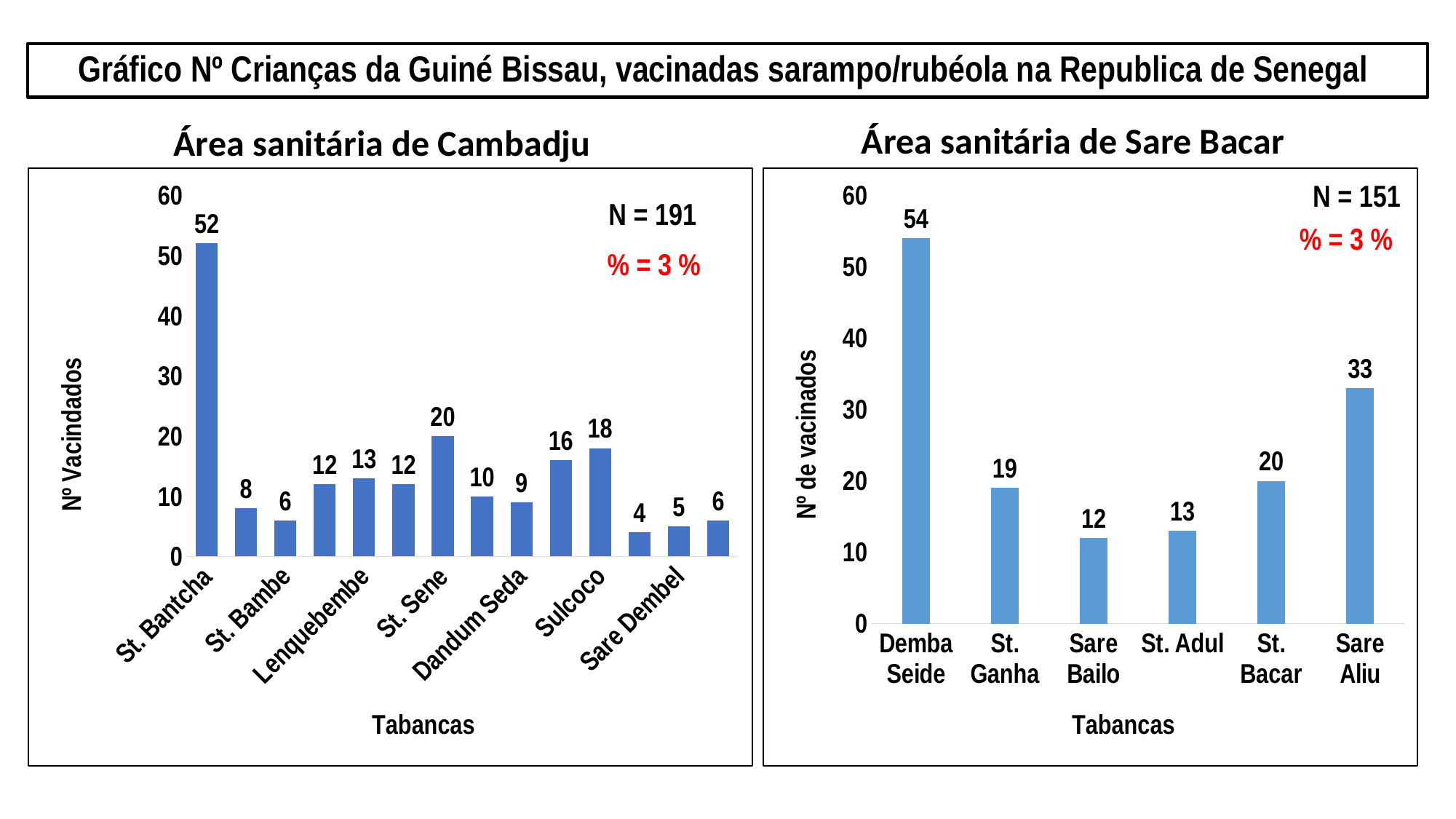
In the 'Área sanitária de Sare Bacar' chart, which tabanca has the lowest number of vaccinated children? Sare Bailo What kind of chart is the 'Área sanitária de Cambadju' chart? Bar chart In the 'Área sanitária de Sare Bacar' chart, which is larger, St. Ganha or St. Adul? St. Ganha In the 'Área sanitária de Sare Bacar' chart, what is the value for St. Bacar? 20 In the 'Área sanitária de Cambadju' chart, which tabanca has the highest number of vaccinated children? St. Bantcha What N value is shown on the 'Área sanitária de Cambadju' chart? N = 191 In the 'Área sanitária de Sare Bacar' chart, which tabanca has the highest value? Demba Seide In the 'Área sanitária de Sare Bacar' chart, how many children were vaccinated in Demba Seide? 54 How many tabancas are shown in the 'Área sanitária de Sare Bacar' chart? 6 In the 'Área sanitária de Sare Bacar' chart, what is the difference between Demba Seide and Sare Aliu? 21 In the 'Área sanitária de Sare Bacar' chart, what is the value for Sare Aliu? 33 In the 'Área sanitária de Cambadju' chart, what is the value for St. Bantcha? 52